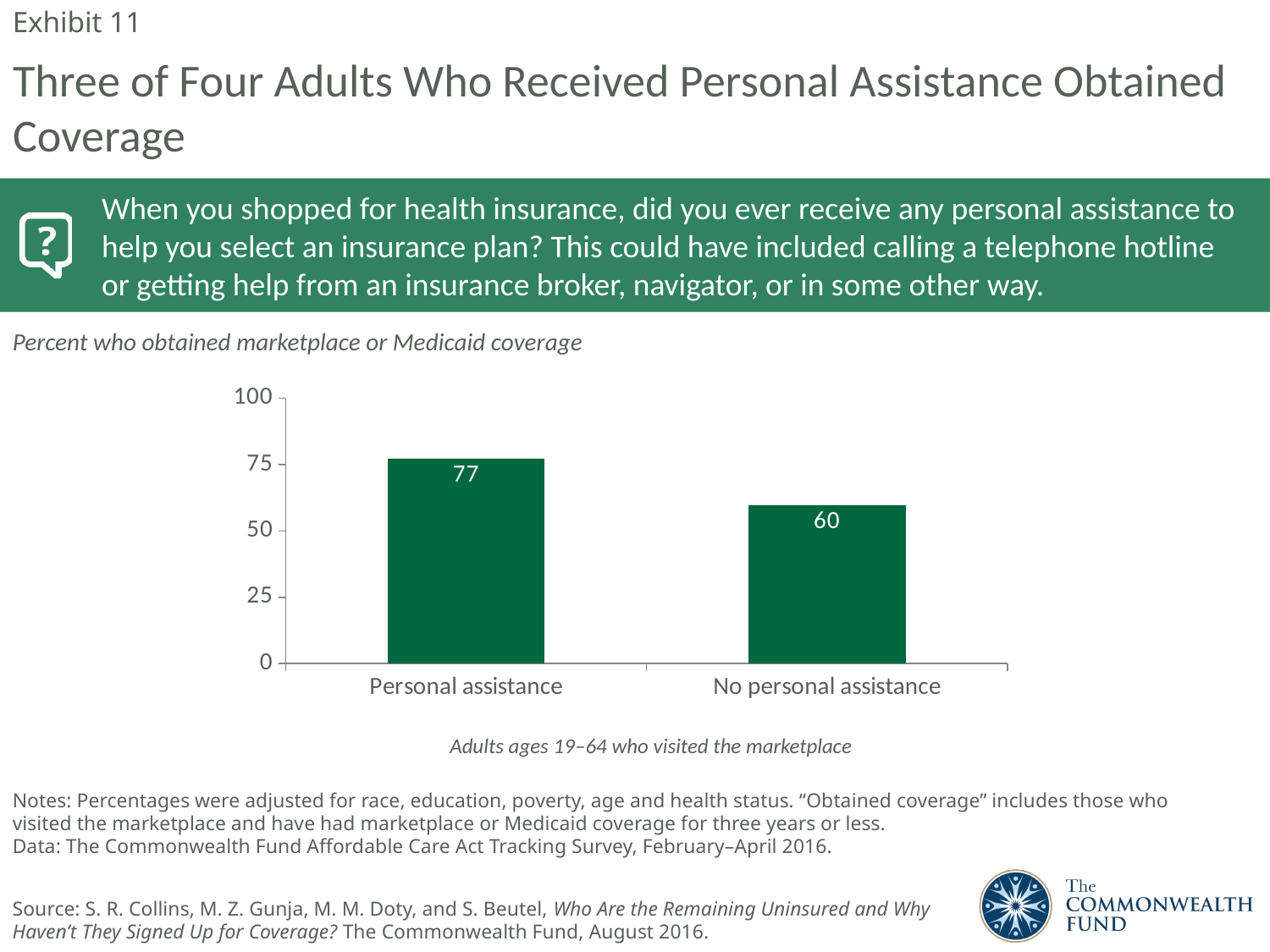
Is the value for Personal assistance greater or less than 75? greater What is the difference in percentage points between the Personal assistance and No personal assistance bars? 17 Which category has the lower percent who obtained coverage? No personal assistance What percent of adults with no personal assistance obtained marketplace or Medicaid coverage? 60 Is the value for Personal assistance larger or smaller than the value for No personal assistance? larger What population does the chart's subtitle below the x axis say the data covers? Adults ages 19–64 who visited the marketplace What is the maximum value shown on the chart's y axis? 100 Is the value for No personal assistance greater or less than 75? less What percent of adults who received personal assistance obtained marketplace or Medicaid coverage? 77 How many categories are shown on the x axis of the chart? 2 What kind of chart is shown on the slide? Bar chart Which category has the higher percent who obtained coverage? Personal assistance